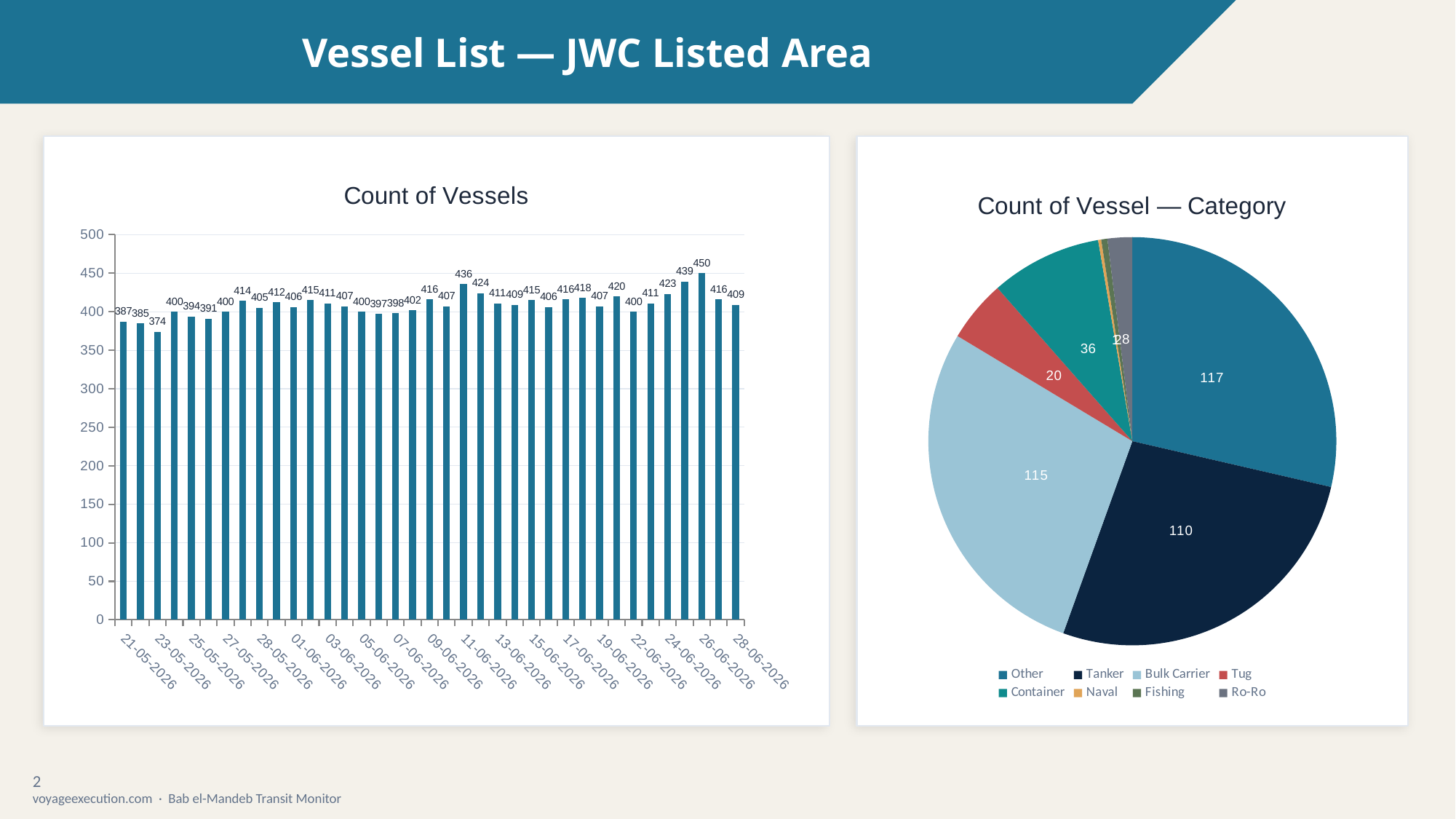
In the 'Count of Vessels' chart, what is the value for 21-05-2026? 387 In the 'Count of Vessel — Category' pie chart, what is the difference between Bulk Carrier and Tanker? 5 In the 'Count of Vessel — Category' pie chart, what is the value for Tanker? 110 In the 'Count of Vessels' chart, which date has the highest count? 26-06-2026 How many categories does the legend of the 'Count of Vessel — Category' pie chart list? 8 In the 'Count of Vessels' chart, what is the difference between the highest value (450) and the lowest value (374)? 76 In the 'Count of Vessels' chart, which date has the lowest count? 23-05-2026 In the 'Count of Vessels' chart, what is the value for 11-06-2026? 436 In the 'Count of Vessel — Category' pie chart, which is larger, Tug or Container? Container In the 'Count of Vessels' chart, what is the value for 28-06-2026? 409 In the 'Count of Vessel — Category' pie chart, what is the value for Other? 117 What kind of chart is the 'Count of Vessels' chart on the left? bar chart